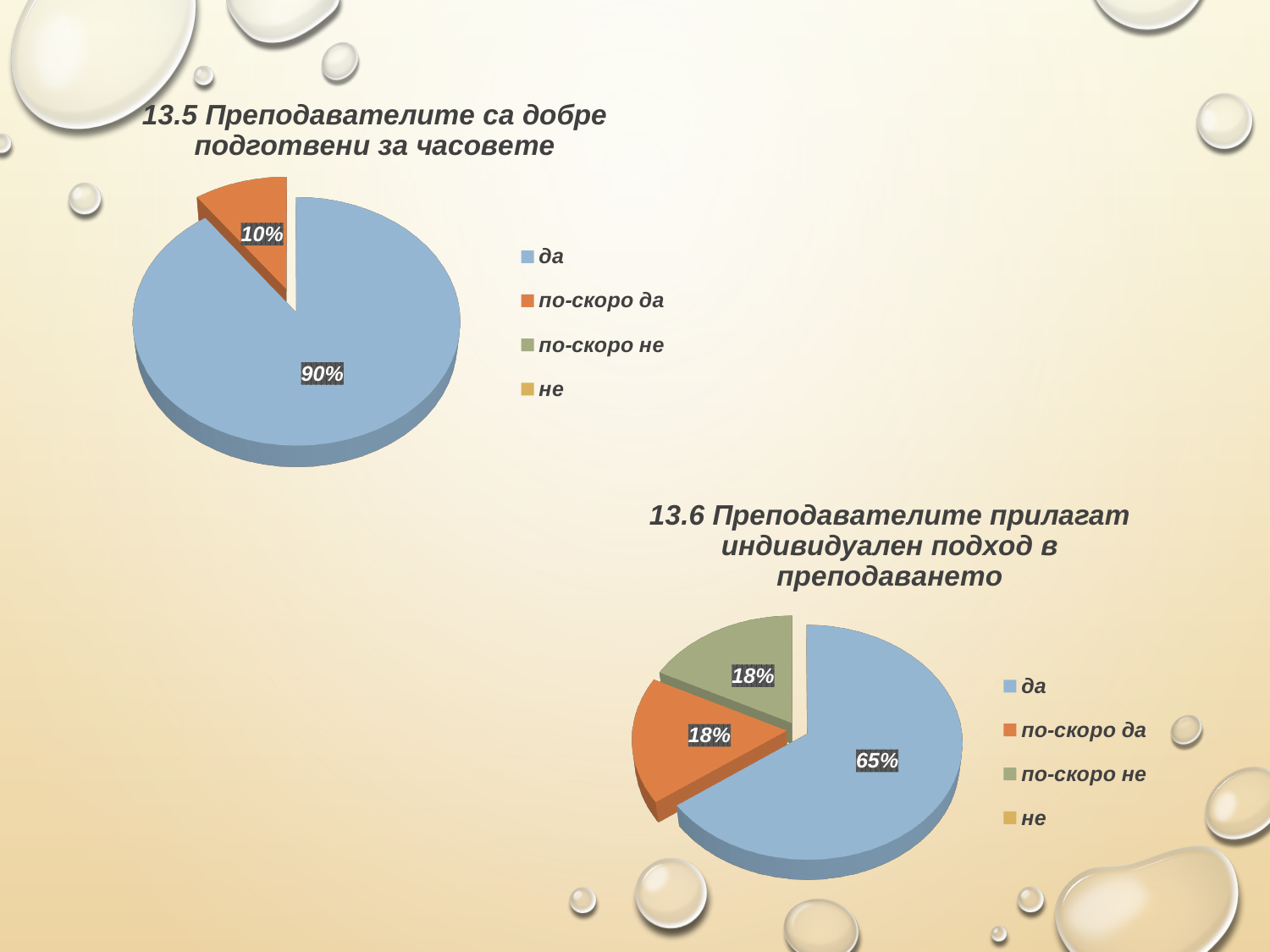
In the chart titled "13.6 Преподавателите прилагат индивидуален подход в преподаването", how many slices have data labels shown? 3 Which chart on the slide has the larger "да" share: the top-left chart (13.5) or the bottom-right chart (13.6)? The top-left chart (13.5) In the chart titled "13.6 Преподавателите прилагат индивидуален подход в преподаването", what is the difference between the "да" slice and the "по-скоро да" slice? 47% In the chart titled "13.5 Преподавателите са добре подготвени за часовете", what is the difference between the "да" and "по-скоро да" slices? 80% In the chart titled "13.6 Преподавателите прилагат индивидуален подход в преподаването", what percentage is shown for "по-скоро не"? 18% In the chart titled "13.5 Преподавателите са добре подготвени за часовете", what percentage is shown for "по-скоро да"? 10% In the chart titled "13.5 Преподавателите са добре подготвени за часовете", which category has the largest slice? да In the chart titled "13.5 Преподавателите са добре подготвени за часовете", how many entries does the legend list? 4 In the chart titled "13.5 Преподавателите са добре подготвени за часовете", what percentage is shown for "да"? 90% In the chart titled "13.6 Преподавателите прилагат индивидуален подход в преподаването", which category has the largest slice? да In the chart titled "13.6 Преподавателите прилагат индивидуален подход в преподаването", what percentage is shown for "да"? 65% What type of chart is the one titled "13.6 Преподавателите прилагат индивидуален подход в преподаването"? Pie chart